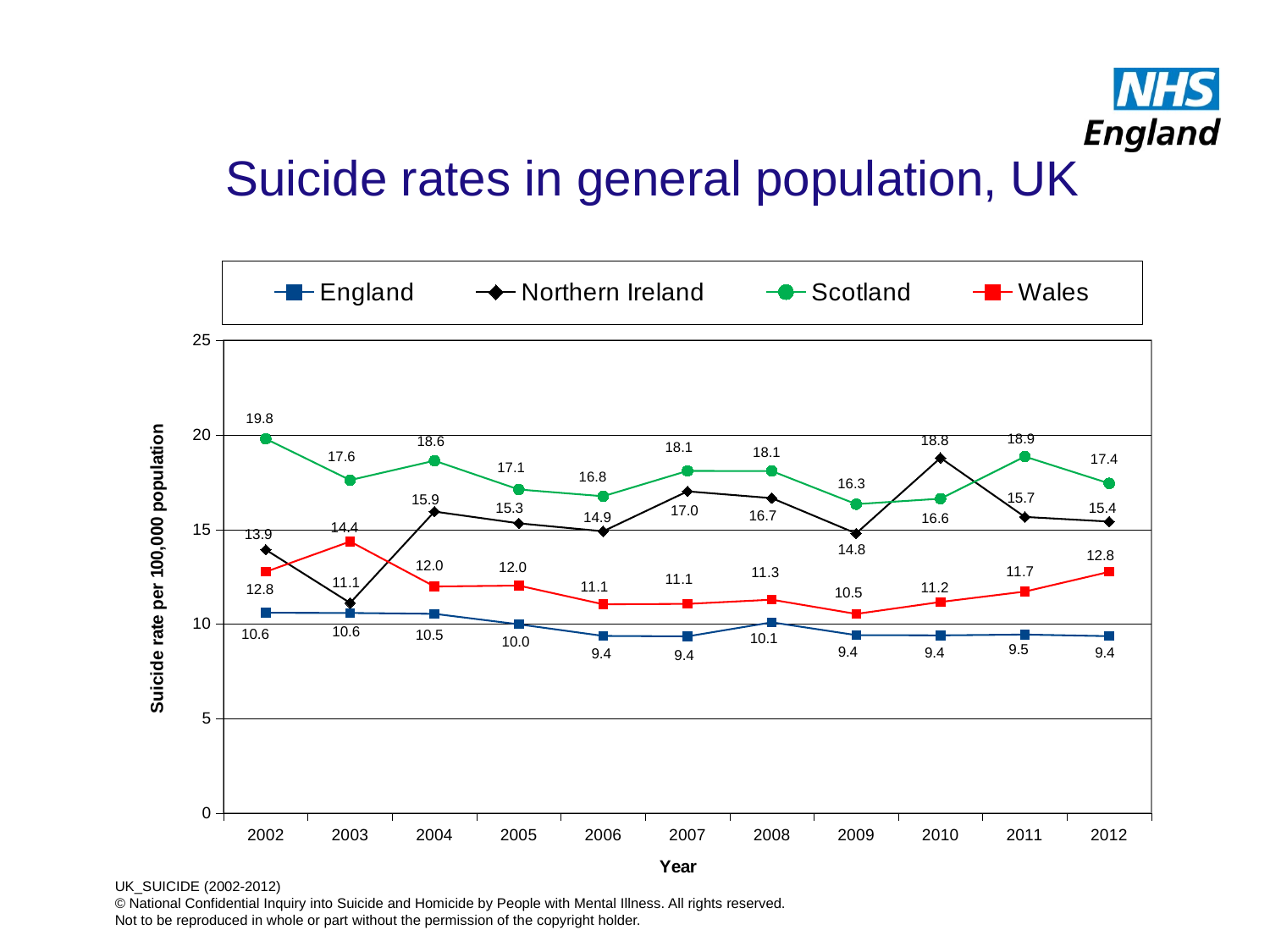
How many series does the legend list? 4 What is the suicide rate for Scotland in 2002? 19.8 How many years are shown on the x axis? 11 In which year does Northern Ireland have its lowest suicide rate? 2003 Which colour is used for the Scotland line? Green What kind of chart is shown on the slide? Line chart In which year does Scotland have its highest suicide rate? 2002 Which is higher in 2010, the rate for Northern Ireland or the rate for Scotland? Northern Ireland What is the difference between the Scotland and England suicide rates in 2012? 8.0 What is the suicide rate for England in 2008? 10.1 What is the suicide rate for Wales in 2003? 14.4 What is the suicide rate for Northern Ireland in 2010? 18.8